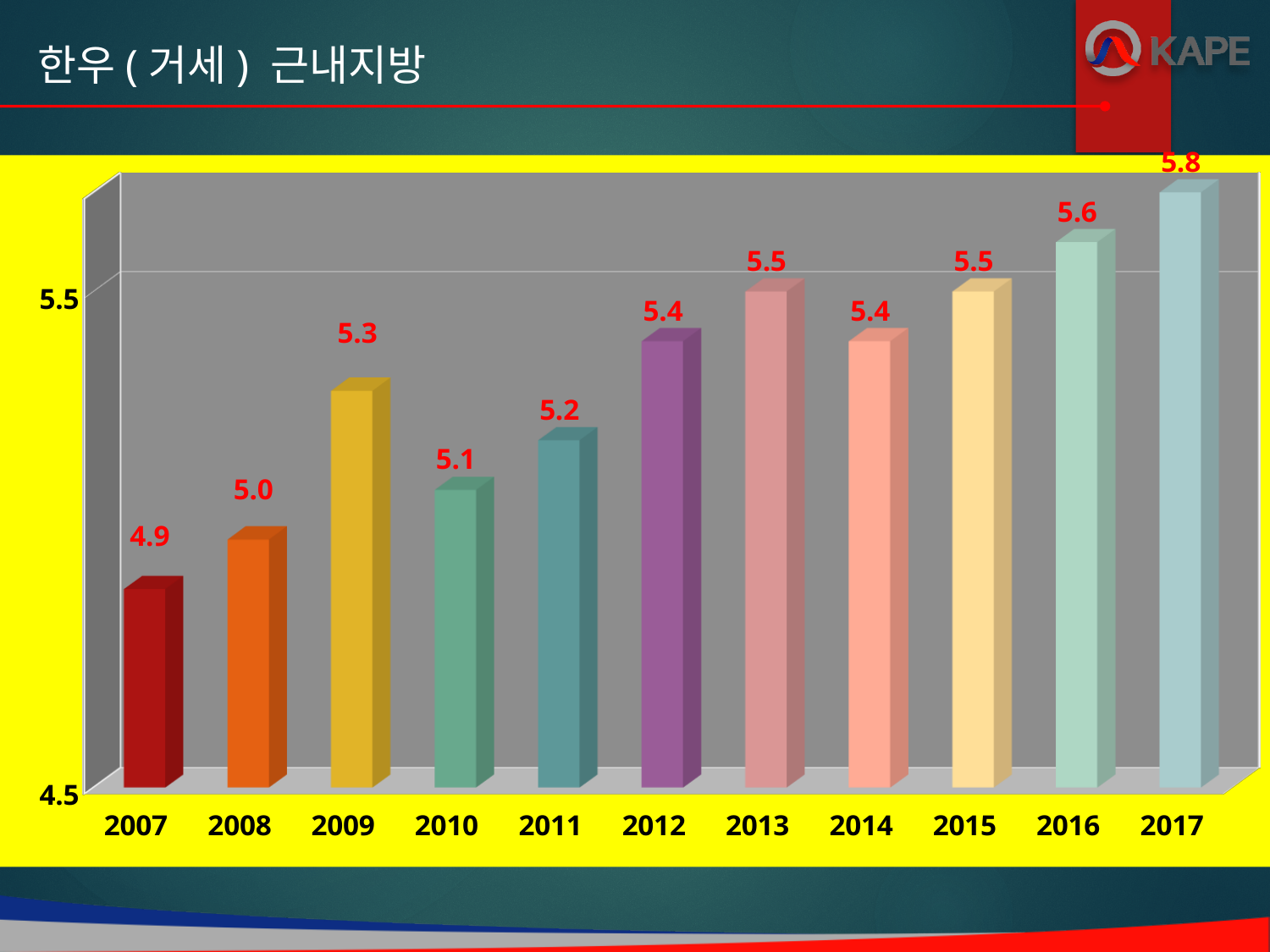
What is the difference between the values for 2017 and 2007? 0.9 Which is larger, the value for 2009 or the value for 2010? 2009 Which year has the lowest value? 2007 How many years are shown on the x axis? 11 Which year has the highest value? 2017 What is the value for 2007? 4.9 What kind of chart is shown on the slide? bar chart What is the difference between the values for 2016 and 2009? 0.3 What is the value for 2017? 5.8 Is the value for 2016 greater or less than 5.5? greater What is the value for 2012? 5.4 Do the values generally rise or fall from 2007 to 2017? rise